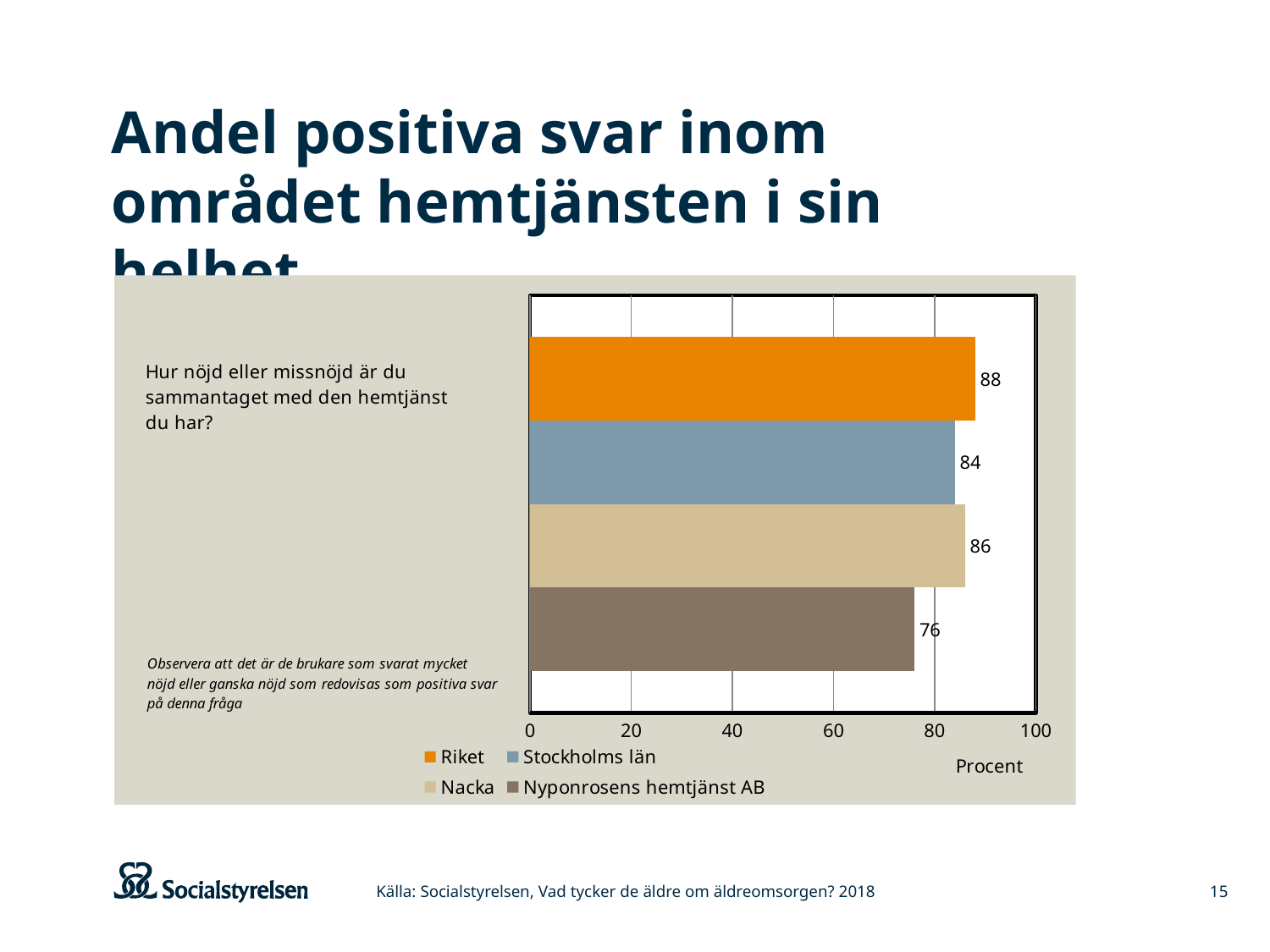
What kind of chart is shown on the slide? Bar chart What is the value for Riket? 88 Which is larger, the value for Nacka or the value for Nyponrosens hemtjänst AB? Nacka What is the difference between the values for Riket and Nyponrosens hemtjänst AB? 12 Which series has the lowest value? Nyponrosens hemtjänst AB What is the value for Nacka? 86 What is the value for Nyponrosens hemtjänst AB? 76 What is the difference between the values for Nacka and Stockholms län? 2 How many series does the legend list? 4 What is the label of the horizontal axis? Procent Which series has the highest value? Riket What is the value for Stockholms län? 84